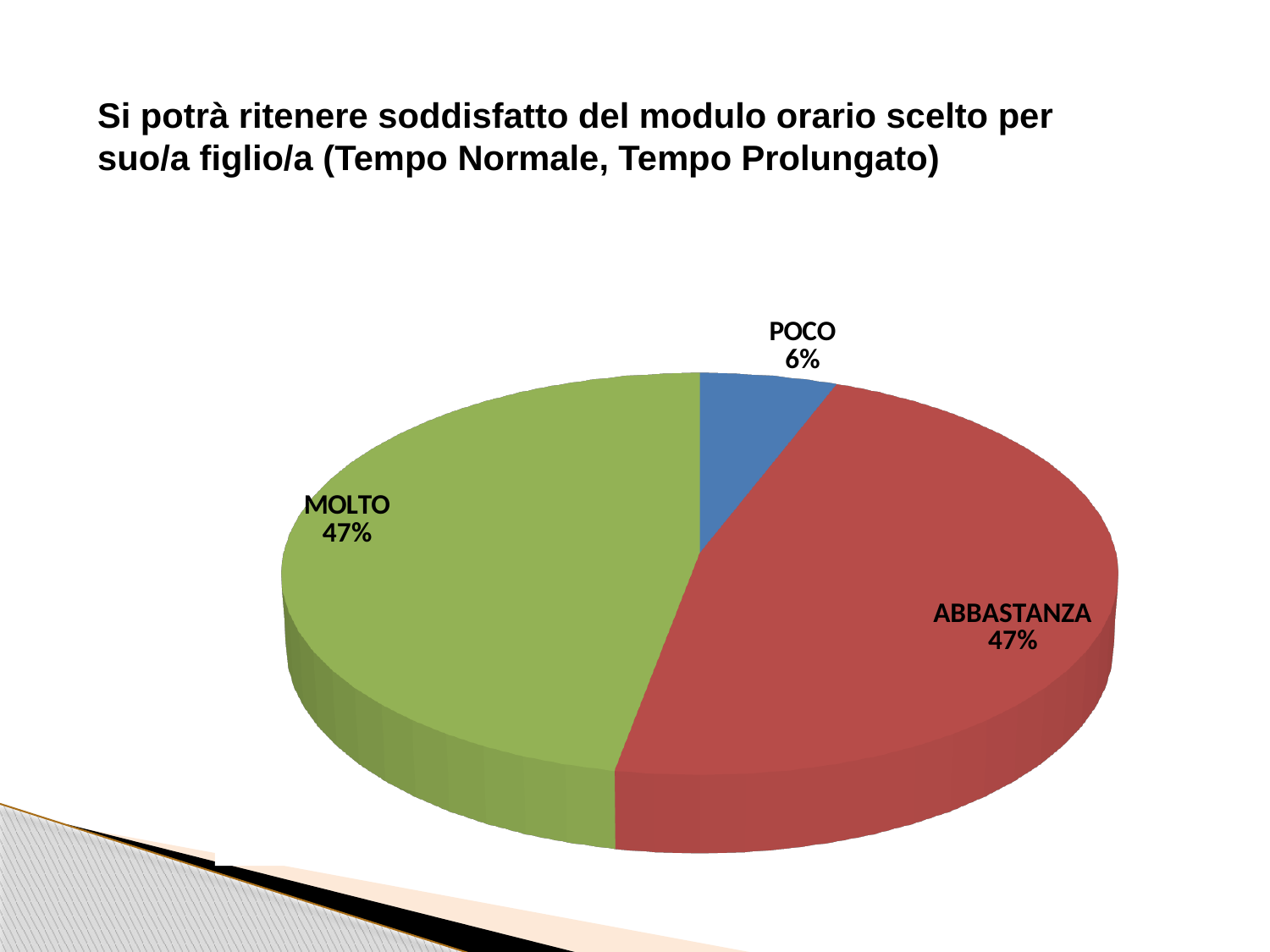
What kind of chart is shown on the slide? Pie chart Which category has the smallest slice of the pie chart? POCO What is the difference between the MOLTO share and the POCO share? 41% Which is larger, the ABBASTANZA slice or the POCO slice? ABBASTANZA What percentage of the pie chart is labelled POCO? 6% What percentage of the pie chart is labelled MOLTO? 47% What colour is the POCO slice in the pie chart? Blue What percentage of the pie chart is labelled ABBASTANZA? 47% What share of the pie does the POCO slice represent? 6% What is the combined share of the MOLTO and ABBASTANZA slices? 94% What colour is the MOLTO slice in the pie chart? Green How many slices does the pie chart have? 3